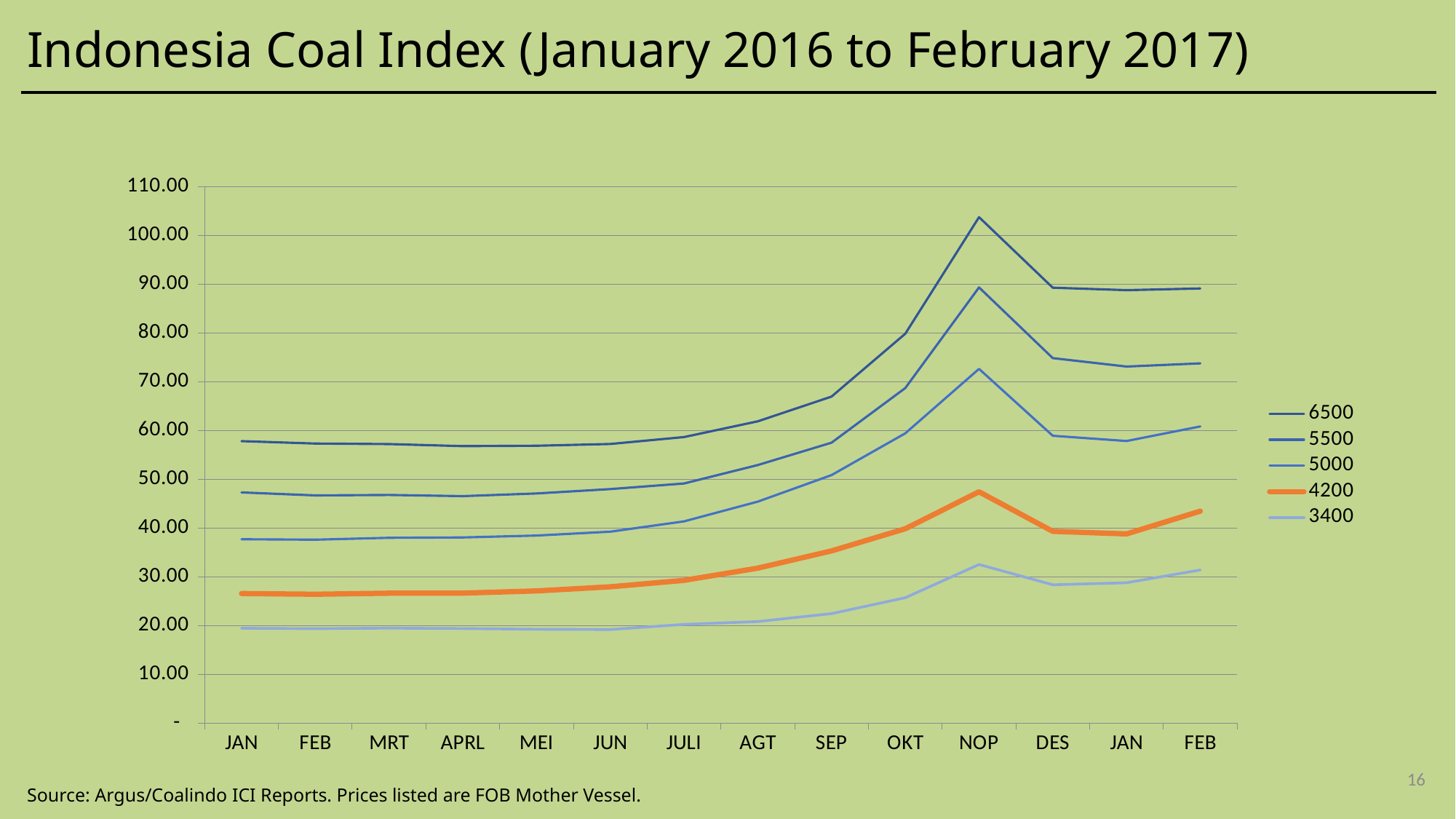
In NOP, which series has the larger value, 5500 or 5000? 5500 Is the value for the 3400 series in NOP greater or less than 30.00? greater Which series has the lowest values across the whole period? 3400 In which month does the 6500 series reach its highest value? NOP Does the 6500 series rise or fall from JUN to NOP? rise Is the value for the 5000 series in the first JAN greater or less than 40.00? less What kind of chart is shown on the slide? line chart How many months are plotted along the x axis? 14 Which series is drawn with the thick orange line? 4200 Is the value for the 6500 series in NOP greater or less than 100.00? greater How many series does the legend list? 5